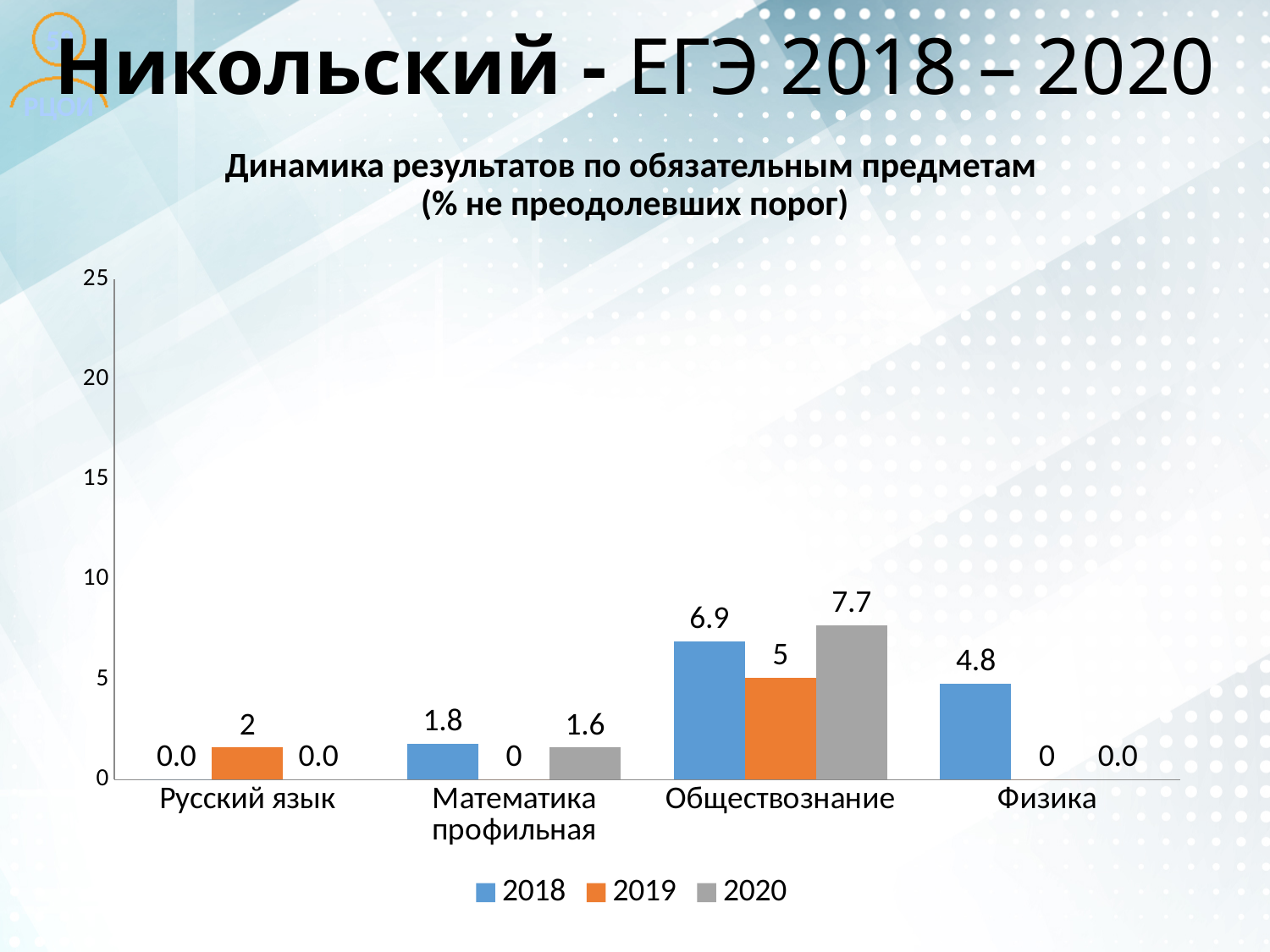
Which category has the highest value in the 2018 series? Обществознание Which category has the lowest value in the 2019 series? Математика профильная and Физика (both 0) What is the value for Русский язык in 2019? 2 What is the difference between the 2020 and 2019 values for Обществознание? 2.7 What is the value for Обществознание in 2020? 7.7 What is the value for Математика профильная in 2020? 1.6 What is the value for Физика in 2018? 4.8 How many categories are shown on the x axis? 4 Which is larger for Математика профильная: the 2018 value or the 2020 value? 2018 What kind of chart is shown on the slide? Bar chart Do the values for Обществознание rise or fall from 2019 to 2020? Rise How many series does the legend list? 3